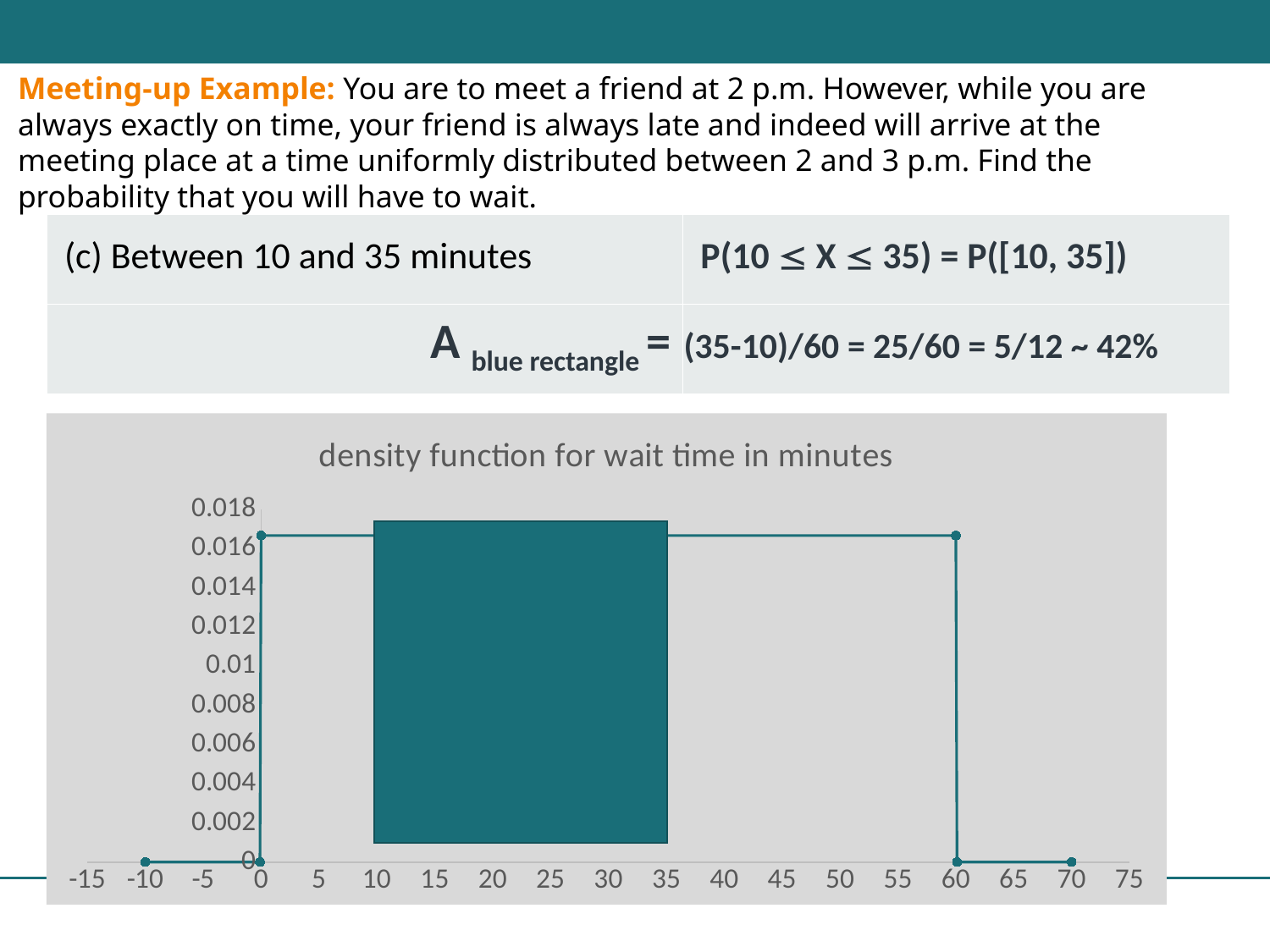
What is the highest tick label shown on the y axis? 0.018 Is the value of the density function at x = 5 greater or less than 0.014? greater What is the value of the density function at x = 70? 0 What is the lowest tick label shown on the x axis? -15 What is the value of the density function at x = -10? 0 Between which two x-axis values does the shaded rectangle extend? 10 and 35 Does the density function rise, fall, or stay flat between x = 10 and x = 50? stay flat Is the value of the density function at x = 65 greater or less than 0.002? less What is the title of the chart? density function for wait time in minutes Is the value of the density function at x = 30 greater or less than 0.01? greater Does the density function rise or fall at x = 60? fall What kind of chart is shown on the slide? line chart